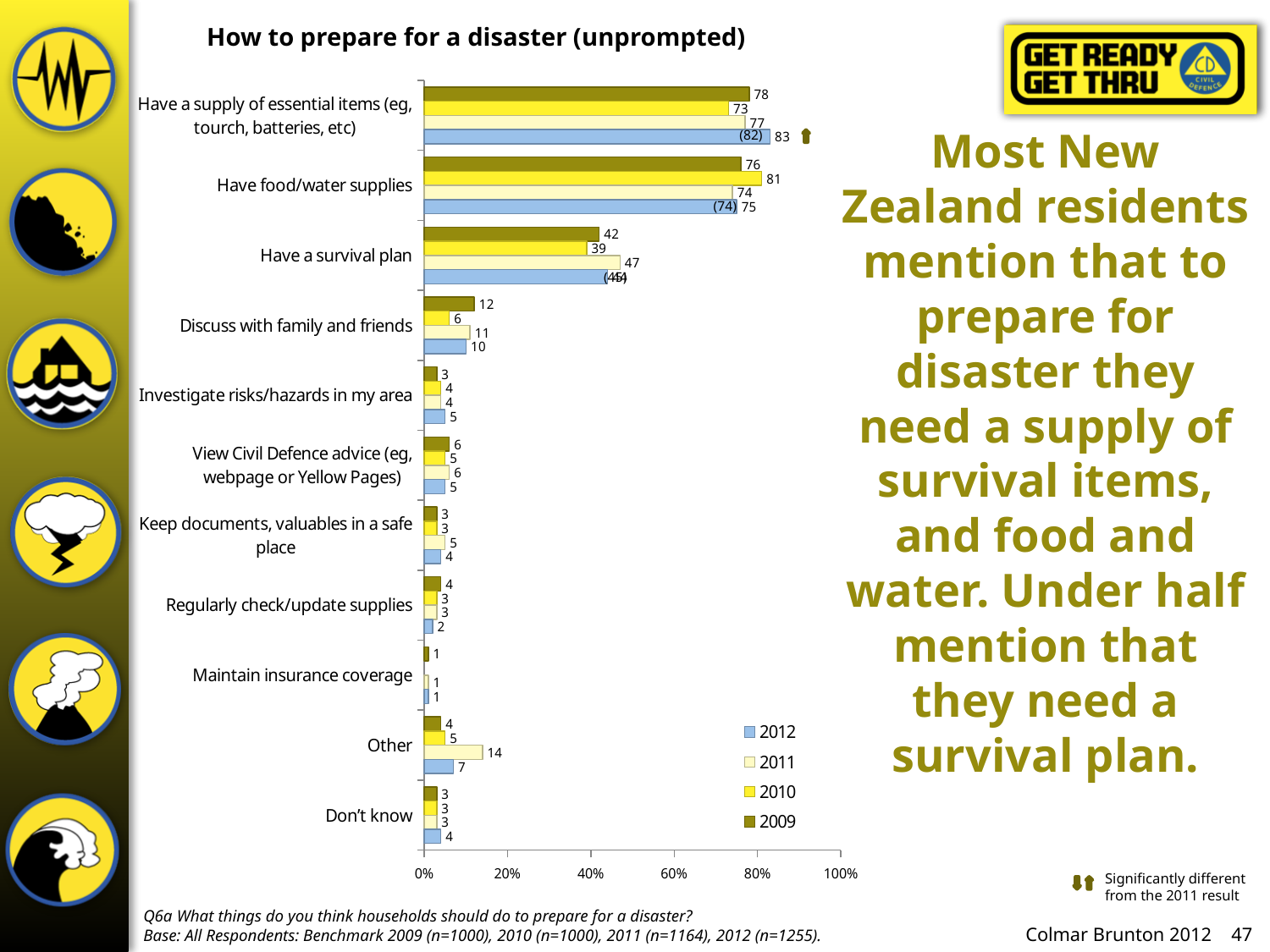
Which is larger for 'Have food/water supplies': the 2009 value or the 2011 value? 2009 What type of chart is shown on the slide? bar chart How many categories are shown on the chart? 11 What is the 2011 value for 'Other'? 14 How many series does the legend list? 4 What is the 2010 value for 'Have food/water supplies'? 81 Which category has the highest 2012 value? Have a supply of essential items (eg, tourch, batteries, etc) Which category has the lowest 2009 value? Maintain insurance coverage What is the title of the chart? How to prepare for a disaster (unprompted) What is the 2012 value for 'Have a supply of essential items (eg, tourch, batteries, etc)'? 83 What is the difference between the 2009 and 2010 values for 'Discuss with family and friends'? 6 What is the 2011 value for 'Have a survival plan'? 47